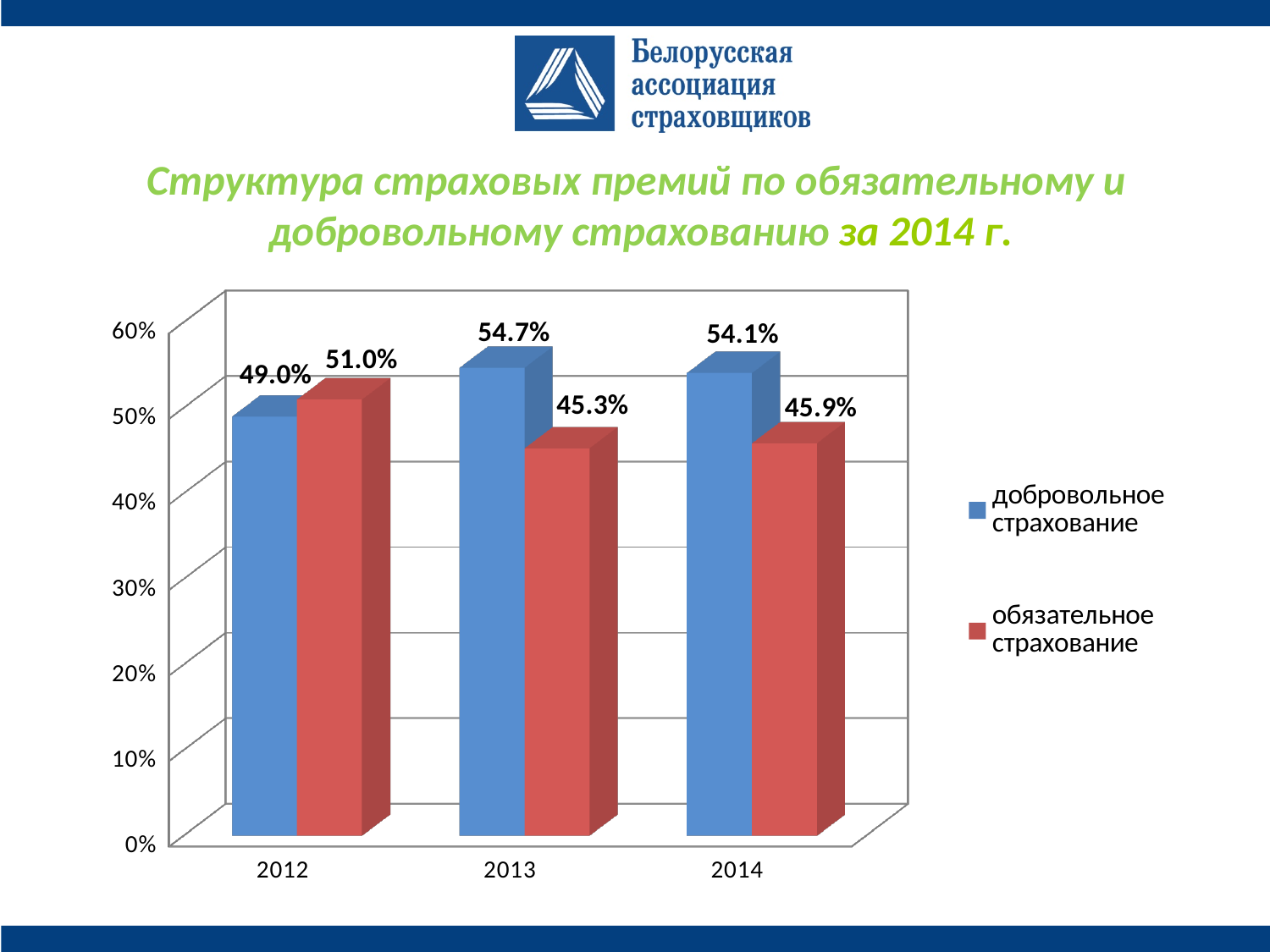
In which year is the value for добровольное страхование highest? 2013 How many years are shown on the x axis? 3 In which year is the value for обязательное страхование lowest? 2013 How many series does the legend list? 2 Which is larger in 2012: добровольное страхование or обязательное страхование? обязательное страхование What is the value for обязательное страхование in 2014? 45.9% Is the value for добровольное страхование in 2014 greater or less than 50%? greater What is the value for добровольное страхование in 2013? 54.7% What is the difference between добровольное страхование and обязательное страхование in 2014? 8.2% What kind of chart is shown on the slide? bar chart Which colour represents обязательное страхование in the chart? red What is the value for обязательное страхование in 2012? 51.0%